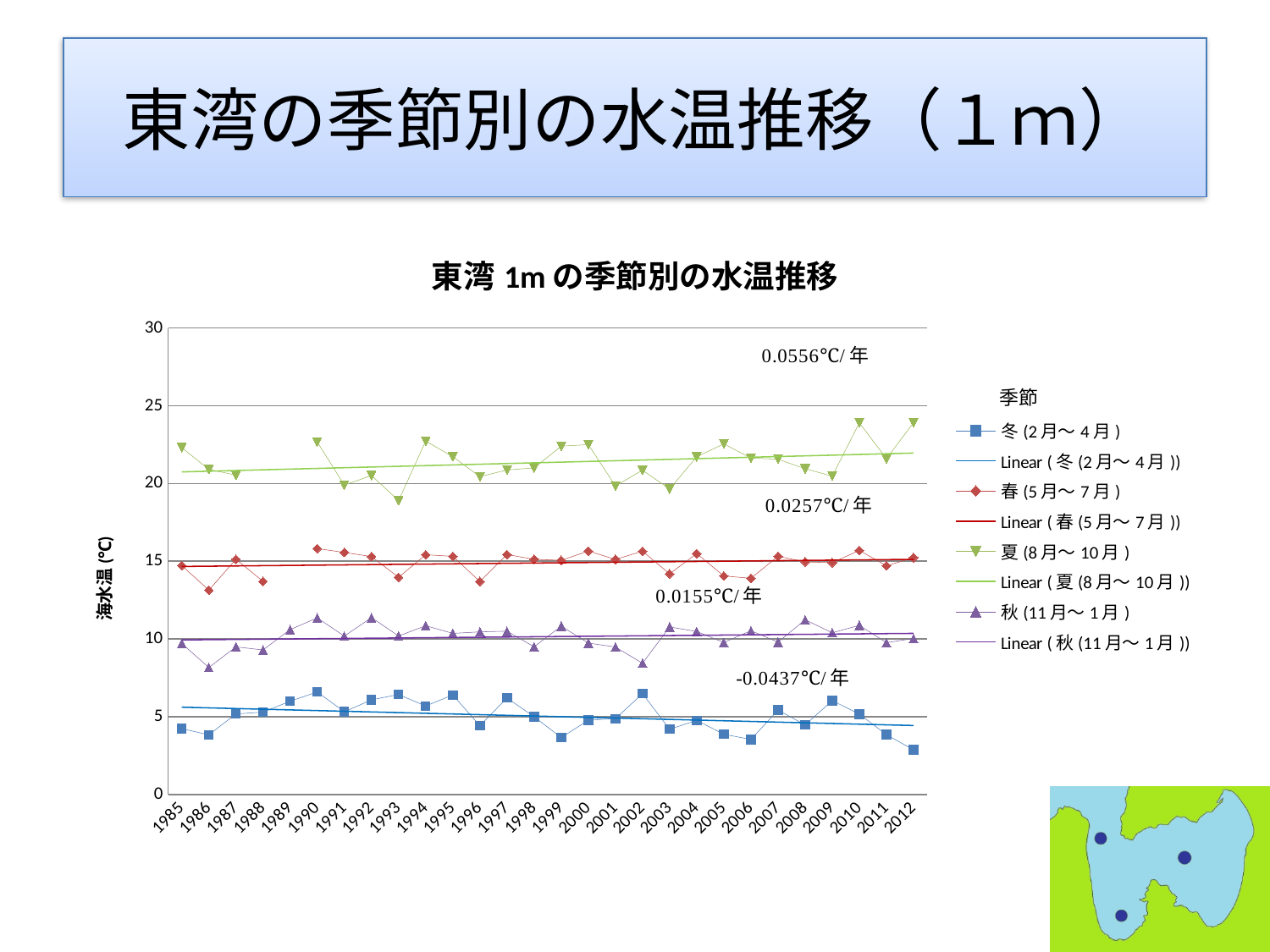
Is the summer (夏) value for 2010 greater or less than 20? greater What is the annotated trend slope for the winter (冬) series? -0.0437℃/年 Does the winter (冬) trend line rise or fall from 1985 to 2012? fall Which season series has the lowest water temperatures across the chart? 冬 (2月～4月) What is the label of the vertical axis? 海水温 (℃) Which is larger, the summer (夏) value for 2012 or the summer (夏) value for 2011? 2012 How many entries does the legend list? 8 What is the annotated trend slope for the summer (夏) series? 0.0556℃/年 Is the winter (冬) value for 2012 greater or less than 5? less What kind of chart is shown on the slide? line chart How many years are plotted along the x axis? 28 Which season series has the highest water temperatures across the chart? 夏 (8月～10月)